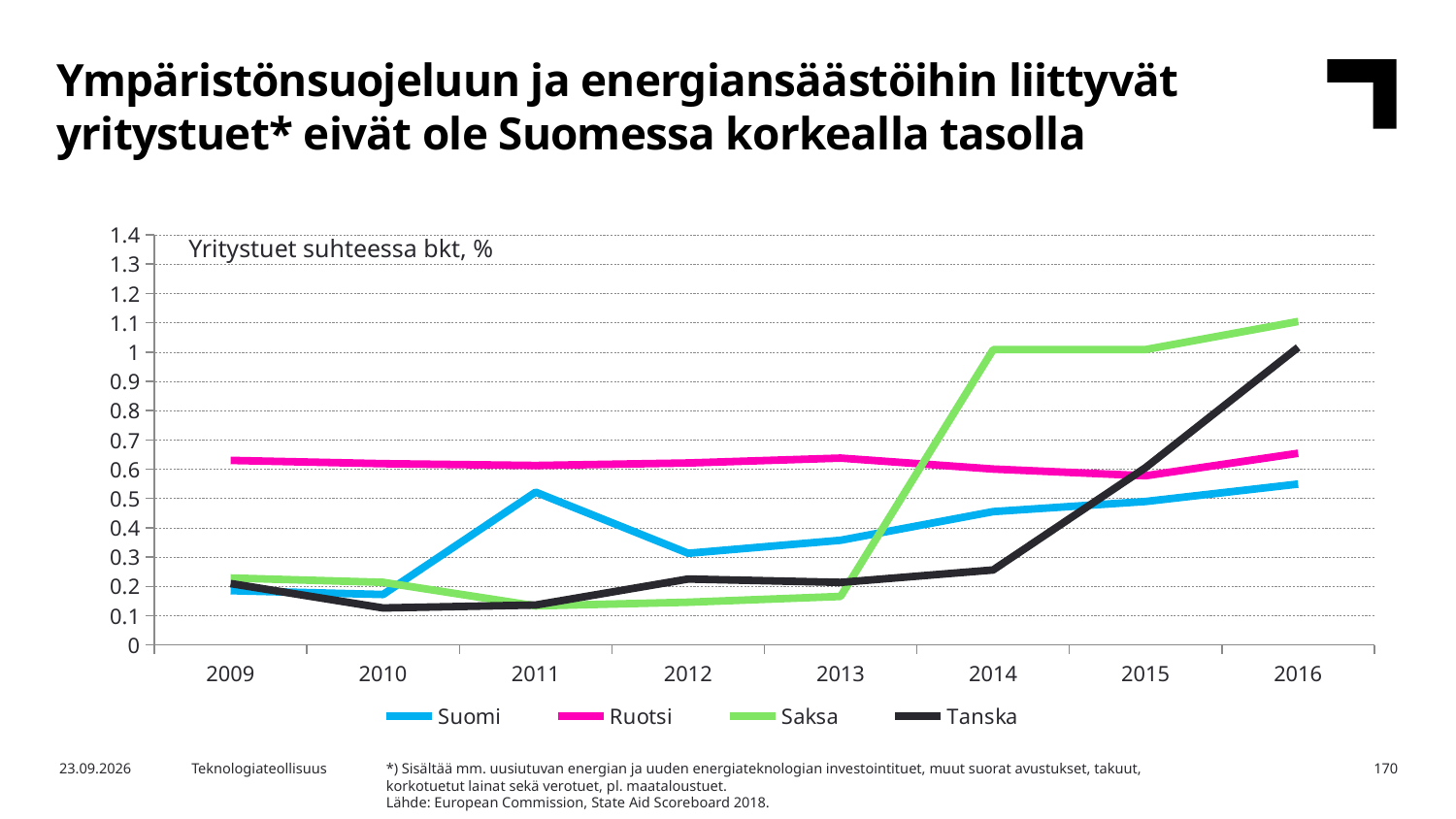
What kind of chart is shown on the slide? line chart How many years are shown on the x axis? 8 In 2013, which is larger: the value for Ruotsi or the value for Suomi? Ruotsi Which country has the highest value in 2016? Saksa Is the value for Suomi in 2011 greater or less than 0.4? greater Is the value for Tanska in 2010 greater or less than 0.2? less How many series does the legend list? 4 Is the value for Saksa in 2016 greater or less than 0.9? greater Which country has the highest value in 2009? Ruotsi Which country has the lowest value in 2016? Suomi In 2014, which is larger: the value for Saksa or the value for Tanska? Saksa Does the value for Tanska rise or fall from 2014 to 2016? rise